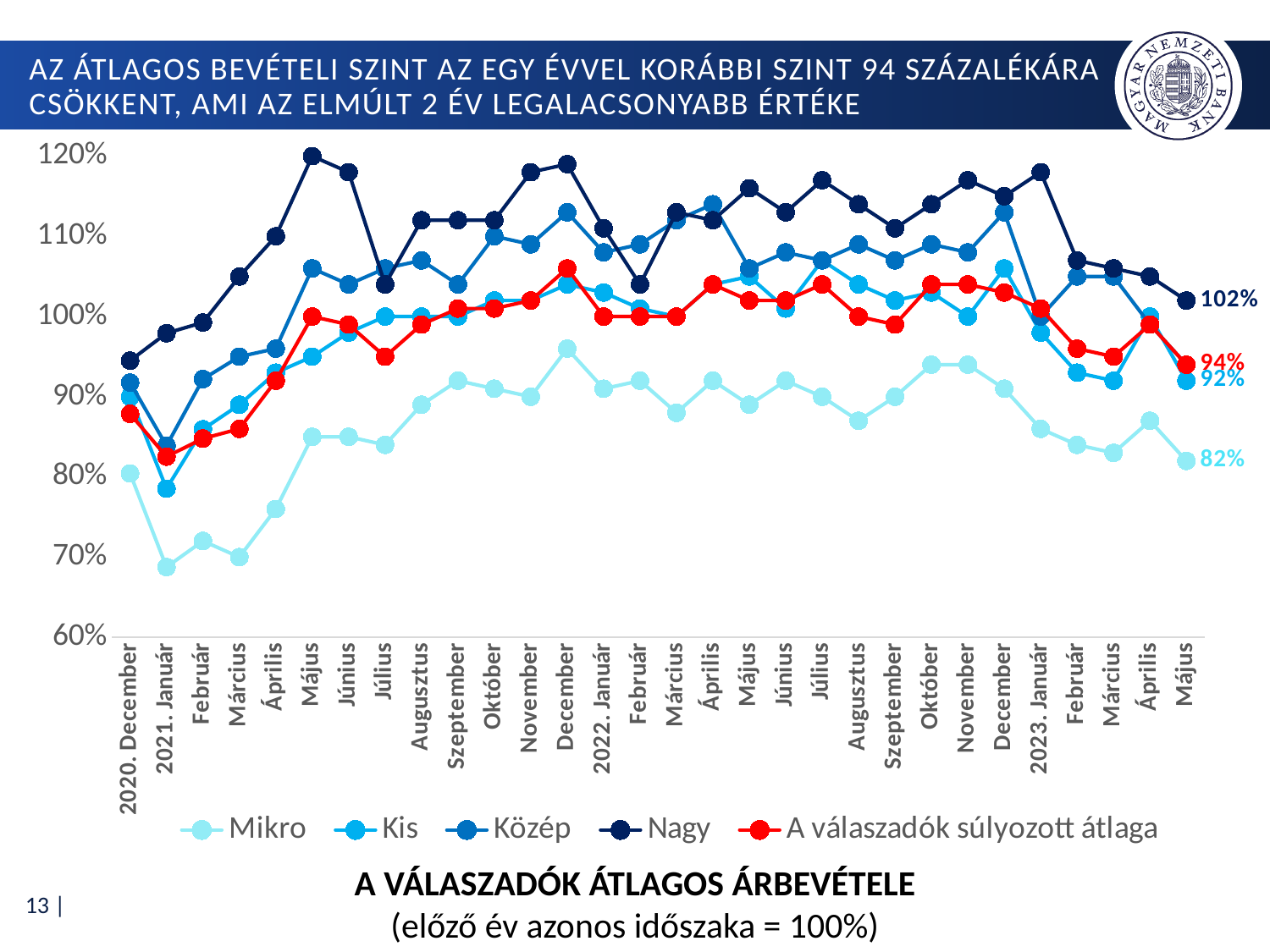
What is the value for Mikro in 2023 Május? 82% Is the value for Nagy in 2021 Május greater or less than 110%? greater Which series has the highest value in 2023 Május? Nagy Is the value for Mikro in 2021 Január greater or less than 70%? less What is the title of the chart? A válaszadók átlagos árbevétele What kind of chart is shown on the slide? line chart What is the value for A válaszadók súlyozott átlaga in 2023 Május? 94% How many series does the legend list? 5 What is the value for Kis in 2023 Május? 92% Which series has the lowest value in 2023 Május? Mikro What is the value for Nagy in 2023 Május? 102% What is the difference between the Nagy and Mikro values in 2023 Május? 20 percentage points